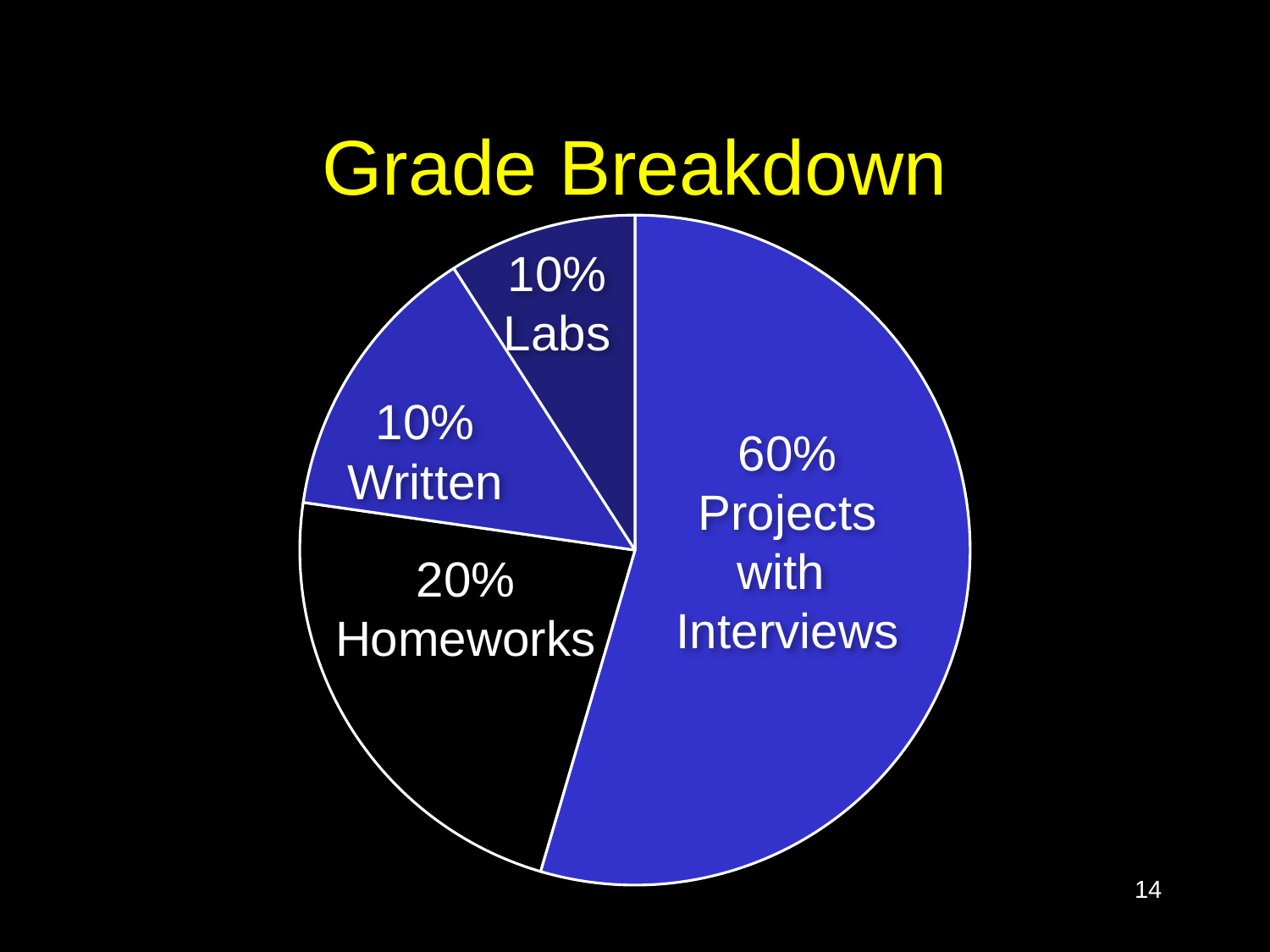
How many slices does the pie chart have? 4 What kind of chart is shown on the slide? Pie chart What share of the grade comes from Homeworks? 20% Which category has the largest share of the grade? Projects with Interviews Is the share for Projects with Interviews greater or less than 50%? greater What is the combined share of Labs and Written? 20% What is the title of the chart? Grade Breakdown Which is larger, the Homeworks share or the Labs share? Homeworks What share of the grade comes from Labs? 10% What share of the grade comes from Projects with Interviews? 60% What is the difference between the Projects with Interviews share and the Homeworks share? 40%